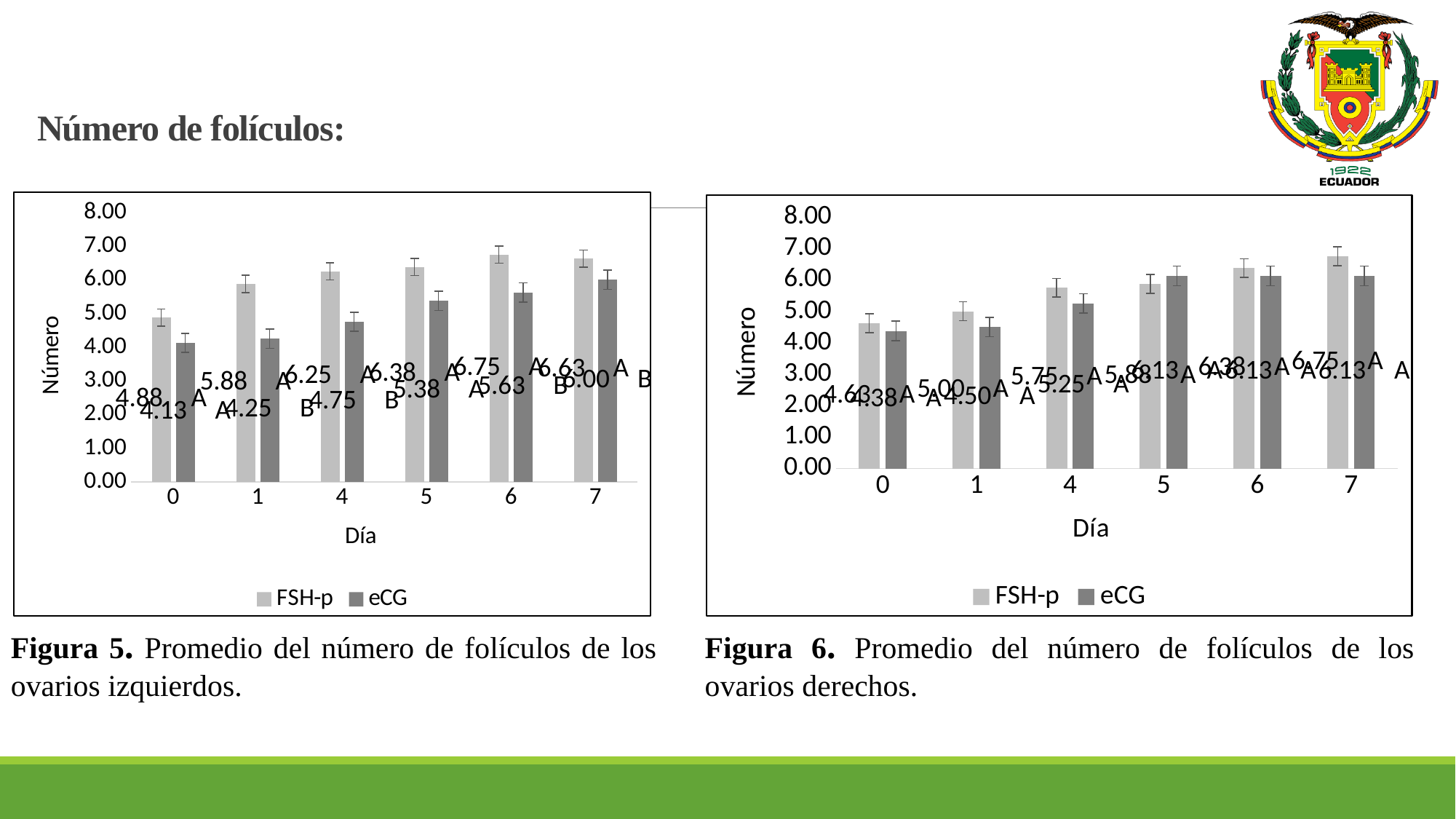
In the left chart (Figura 5), on which day is the FSH-p value highest? 6 In the left chart (Figura 5), how many series does the legend list? 2 In the left chart (Figura 5), what is the eCG value on day 0? 4.13 In the left chart (Figura 5), what kind of chart is shown? bar chart In the left chart (Figura 5), what is the difference between the FSH-p and eCG values on day 4? 1.50 In the right chart (Figura 6), what is the eCG value on day 4? 5.25 In the left chart (Figura 5), do the eCG values rise or fall from day 0 to day 7? rise In the right chart (Figura 6), what is the FSH-p value on day 7? 6.75 In the left chart (Figura 5), how many days are shown on the x axis? 6 In the right chart (Figura 6), which series has the larger value on day 1, FSH-p or eCG? FSH-p In the left chart (Figura 5), what is the FSH-p value on day 6? 6.75 In the right chart (Figura 6), what are the two series named in the legend? FSH-p and eCG